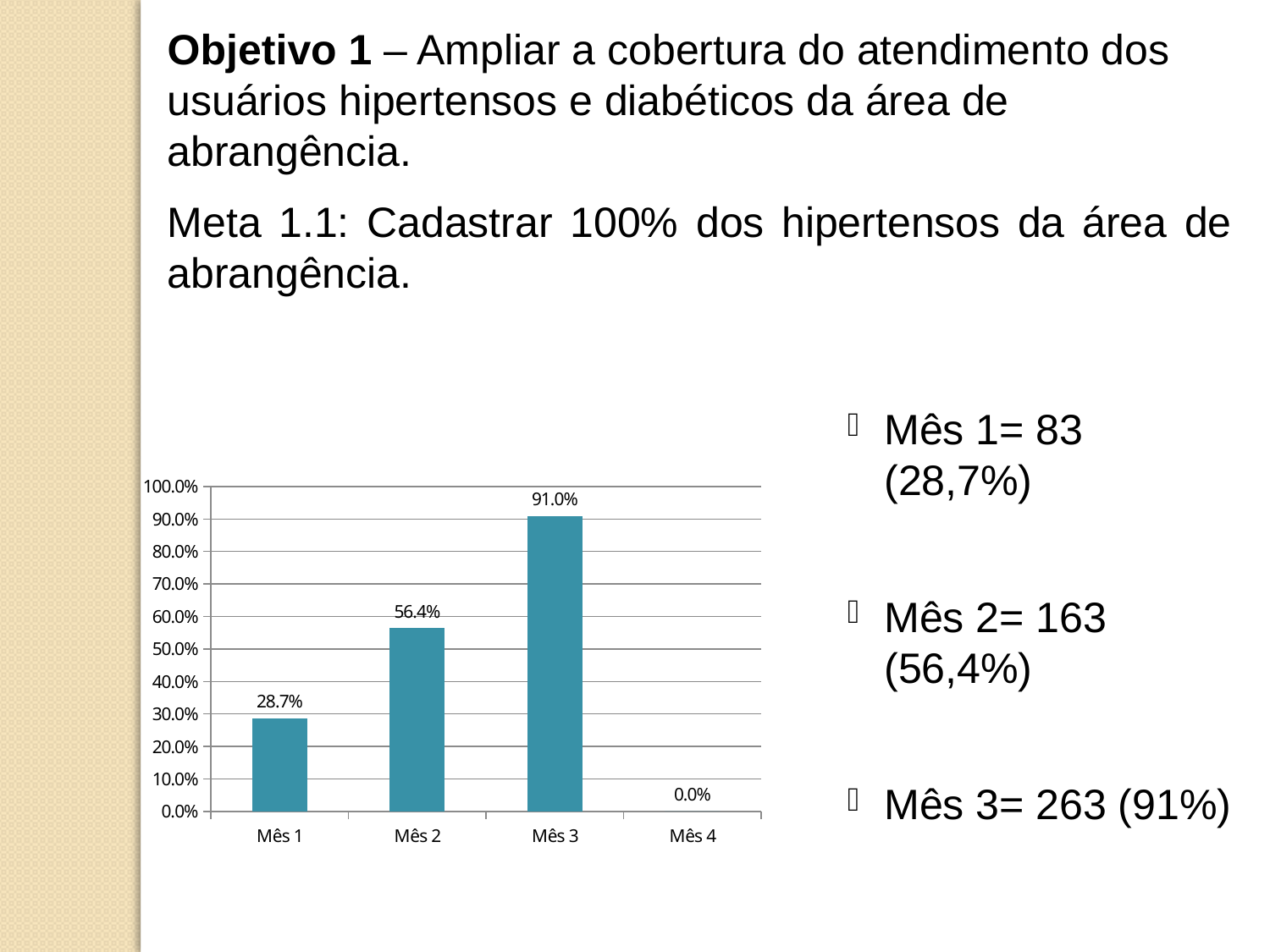
What is the difference between the values for Mês 2 and Mês 1? 27.7% What is the value for Mês 1? 28.7% How many categories are shown on the x axis? 4 What is the value for Mês 4? 0.0% What is the difference between the values for Mês 3 and Mês 2? 34.6% What kind of chart is shown on the slide? Bar chart Do the values rise or fall from Mês 1 to Mês 3? Rise Which category has the lowest value? Mês 4 Which is larger, the value for Mês 1 or the value for Mês 2? Mês 2 What is the value for Mês 3? 91.0% What is the value for Mês 2? 56.4% Which category has the highest value? Mês 3